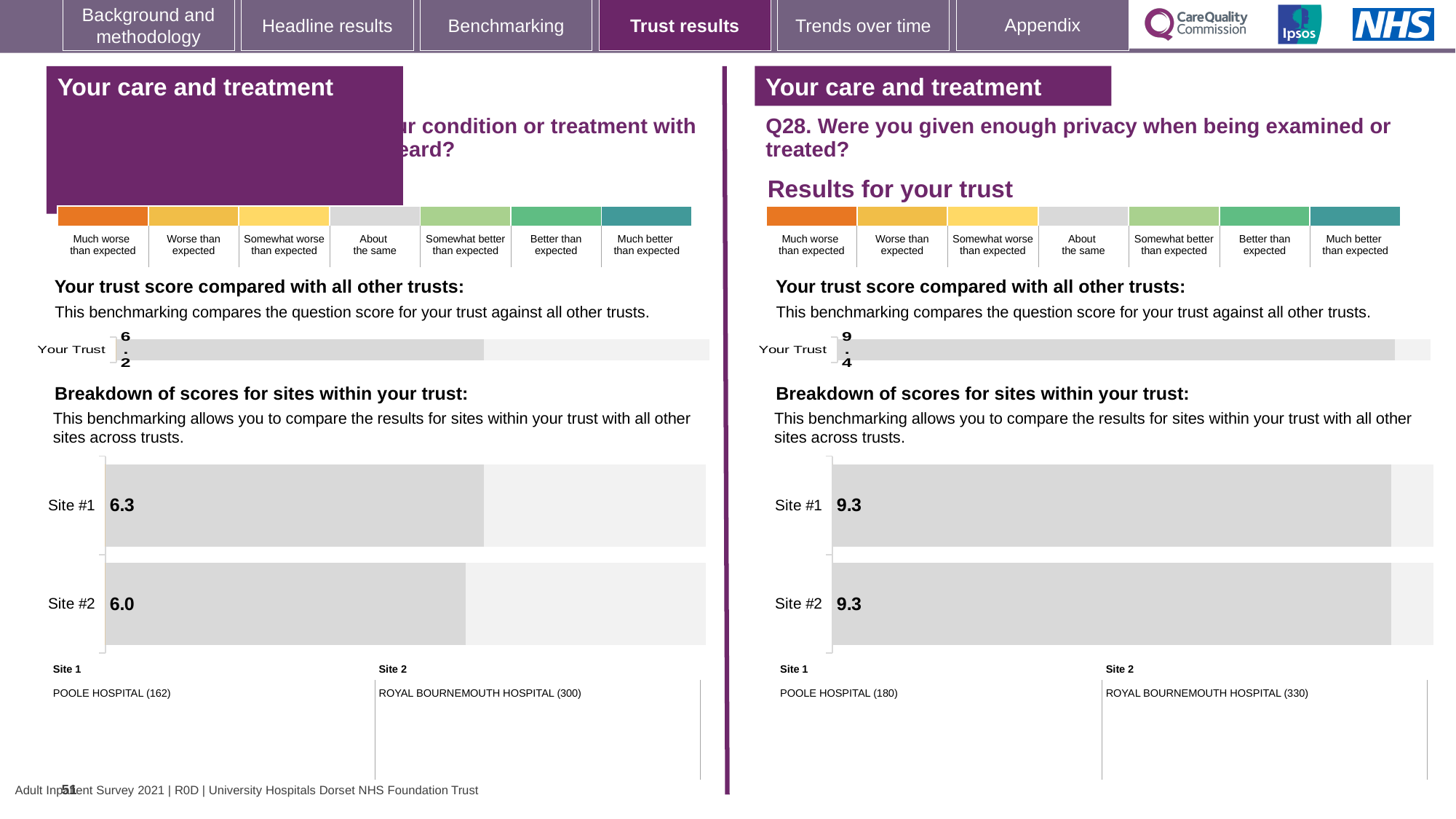
On the left-hand site breakdown chart, what is the difference between the Site #1 and Site #2 scores? 0.3 On the Q28 (right-hand) 'Your trust score compared with all other trusts' chart, what is the score shown for Your Trust? 9.4 On the Q28 (right-hand) 'Breakdown of scores for sites within your trust' chart, what is the score for Site #1? 9.3 On the left-hand 'Your trust score compared with all other trusts' chart, what is the score shown for Your Trust? 6.2 On the left-hand site breakdown chart, which site has the lower score? Site #2 On the Q28 (right-hand) site breakdown chart, how many sites are shown? 2 On the Q28 (right-hand) 'Breakdown of scores for sites within your trust' chart, what is the score for Site #2? 9.3 On the left-hand site breakdown chart, which site has the higher score? Site #1 On the left-hand 'Breakdown of scores for sites within your trust' chart, what is the score for Site #2? 6.0 On the Q28 (right-hand) site breakdown chart, is the Site #1 score larger than, smaller than, or equal to the Site #2 score? Equal On the left-hand 'Breakdown of scores for sites within your trust' chart, what is the score for Site #1? 6.3 What type of chart is used for the site breakdown on the left-hand side of the slide? Bar chart